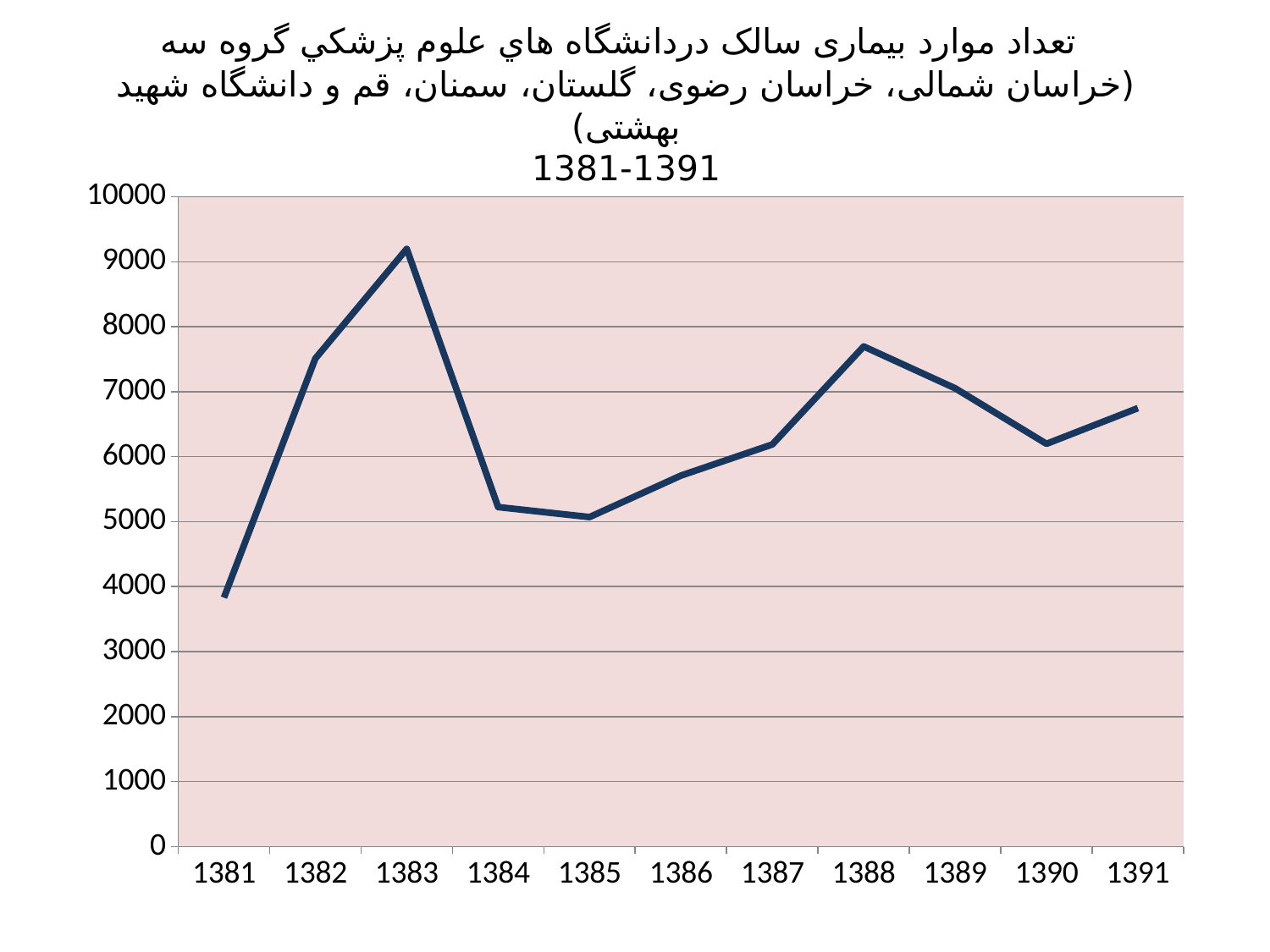
What kind of chart is shown on the slide? line chart Do the values rise or fall from 1385 to 1388? rise Which year has the lowest value? 1381 Which year has the highest value? 1383 Is the value for 1381 greater or less than 4000? less Is the value for 1383 greater or less than 9000? greater What year range is given in the chart title? 1381-1391 Which is larger, the value for 1388 or the value for 1390? 1388 Is the value for 1388 greater or less than 7000? greater Which is larger, the value for 1382 or the value for 1384? 1382 How many years are plotted along the x axis? 11